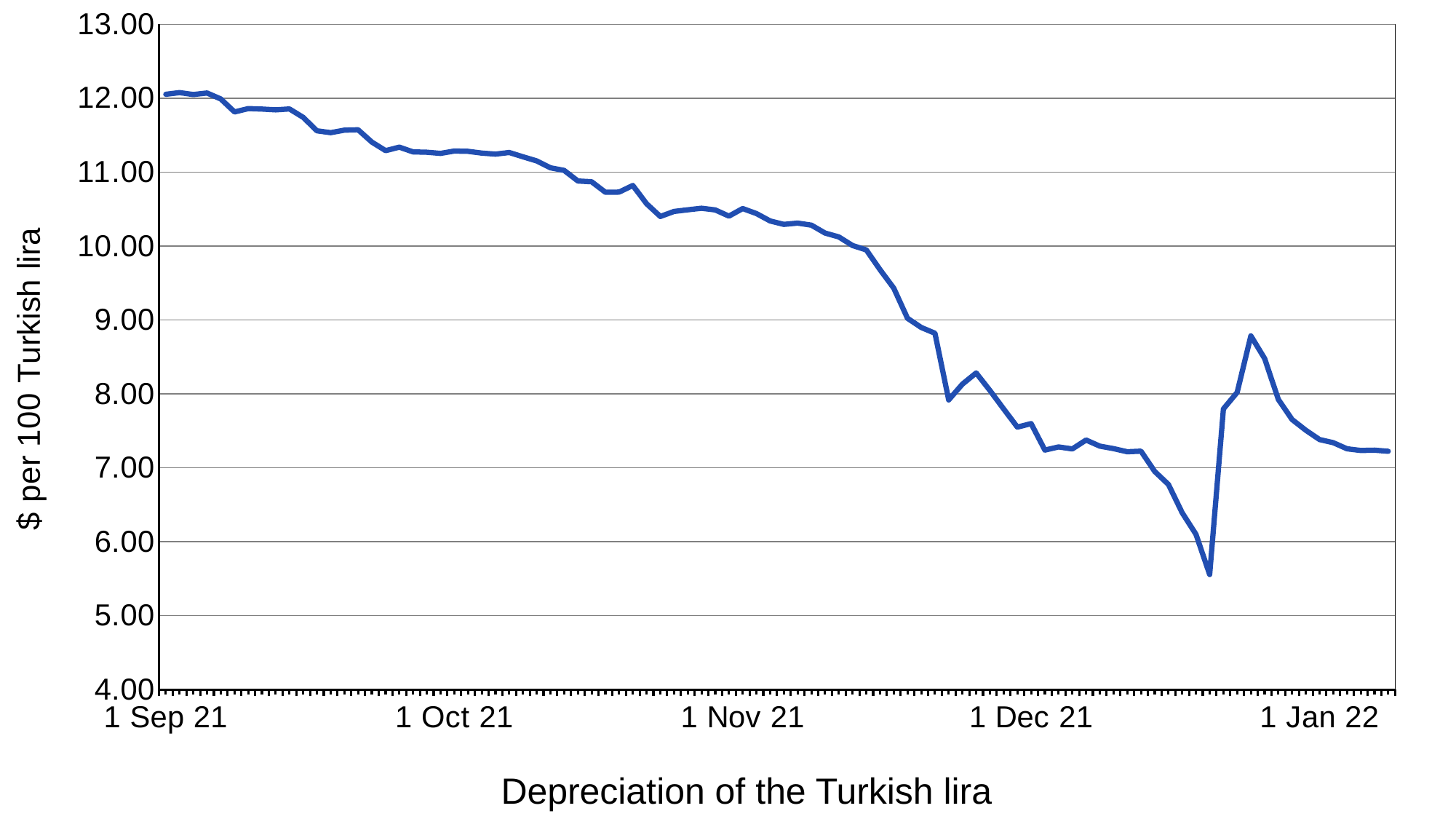
Is the lowest point of the line greater or less than 6.00? less What kind of chart is shown on the slide? Line chart Is the value at 1 Sep 21 greater or less than 11.00? greater Which is larger, the value at 1 Sep 21 or the value at 1 Jan 22? 1 Sep 21 Overall, does the value rise or fall from 1 Sep 21 to 1 Jan 22? Fall How many date labels are shown on the horizontal axis? 5 What is the title of the chart? Depreciation of the Turkish lira Is the value at 1 Nov 21 greater or less than 10.00? greater What is the label on the vertical axis of the chart? $ per 100 Turkish lira In which month does the line reach its lowest point? December 2021